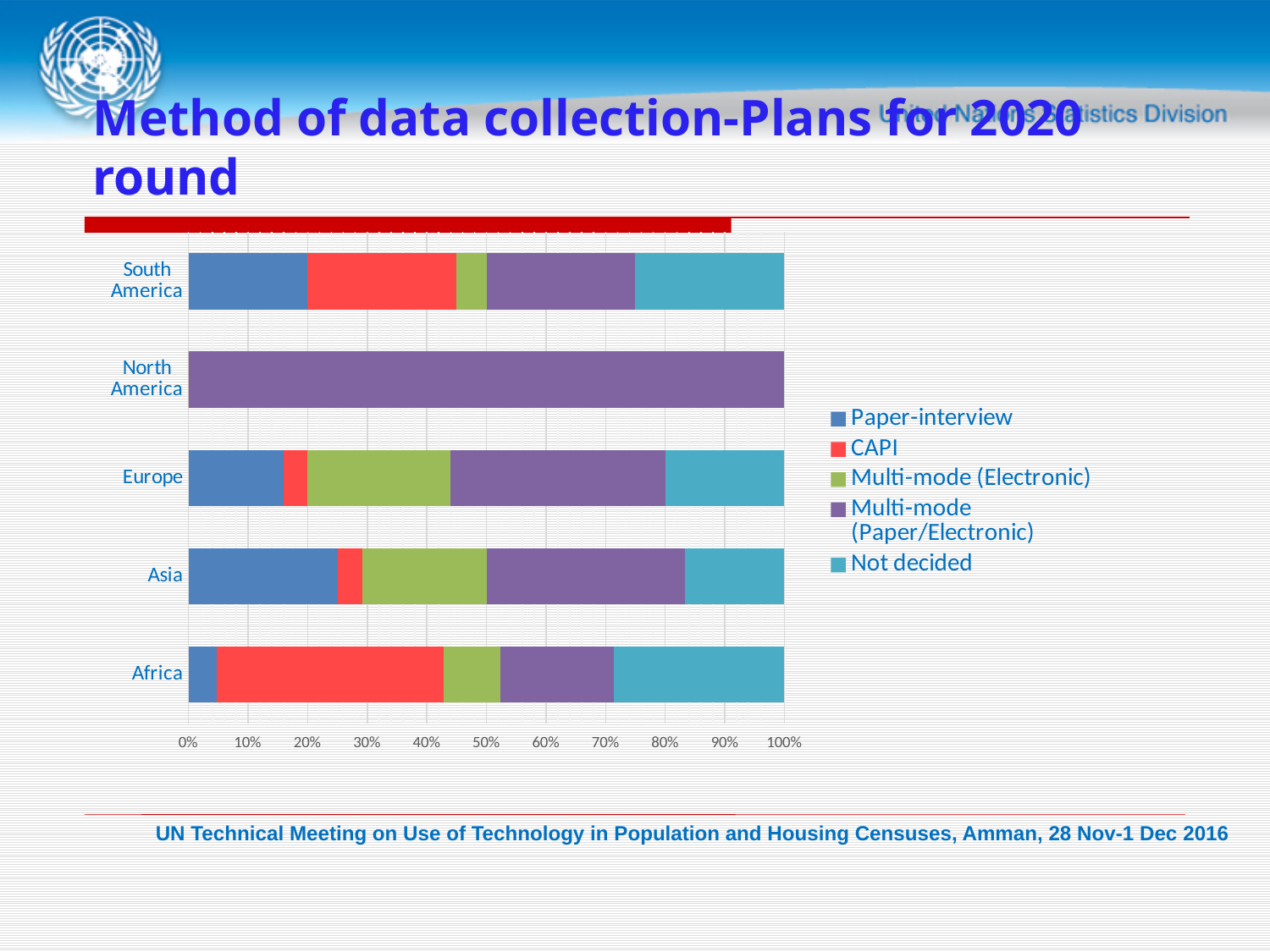
Is the CAPI segment for Africa greater or less than 30%? greater Which data collection method accounts for 100% of the North America bar? Multi-mode (Paper/Electronic) Which region has the largest CAPI segment? Africa Is the Paper-interview segment larger for Asia or for Africa? Asia What kind of chart is shown on the slide? Stacked bar chart How many regions are shown on the chart? 5 Is the Paper-interview segment for Africa greater or less than 10%? less What share of the North America bar is Multi-mode (Paper/Electronic)? 100% Is the CAPI segment for Europe greater or less than 10%? less Which legend entry is shown in red? CAPI How many series does the legend list? 5 Is the CAPI segment larger for Africa or for Europe? Africa